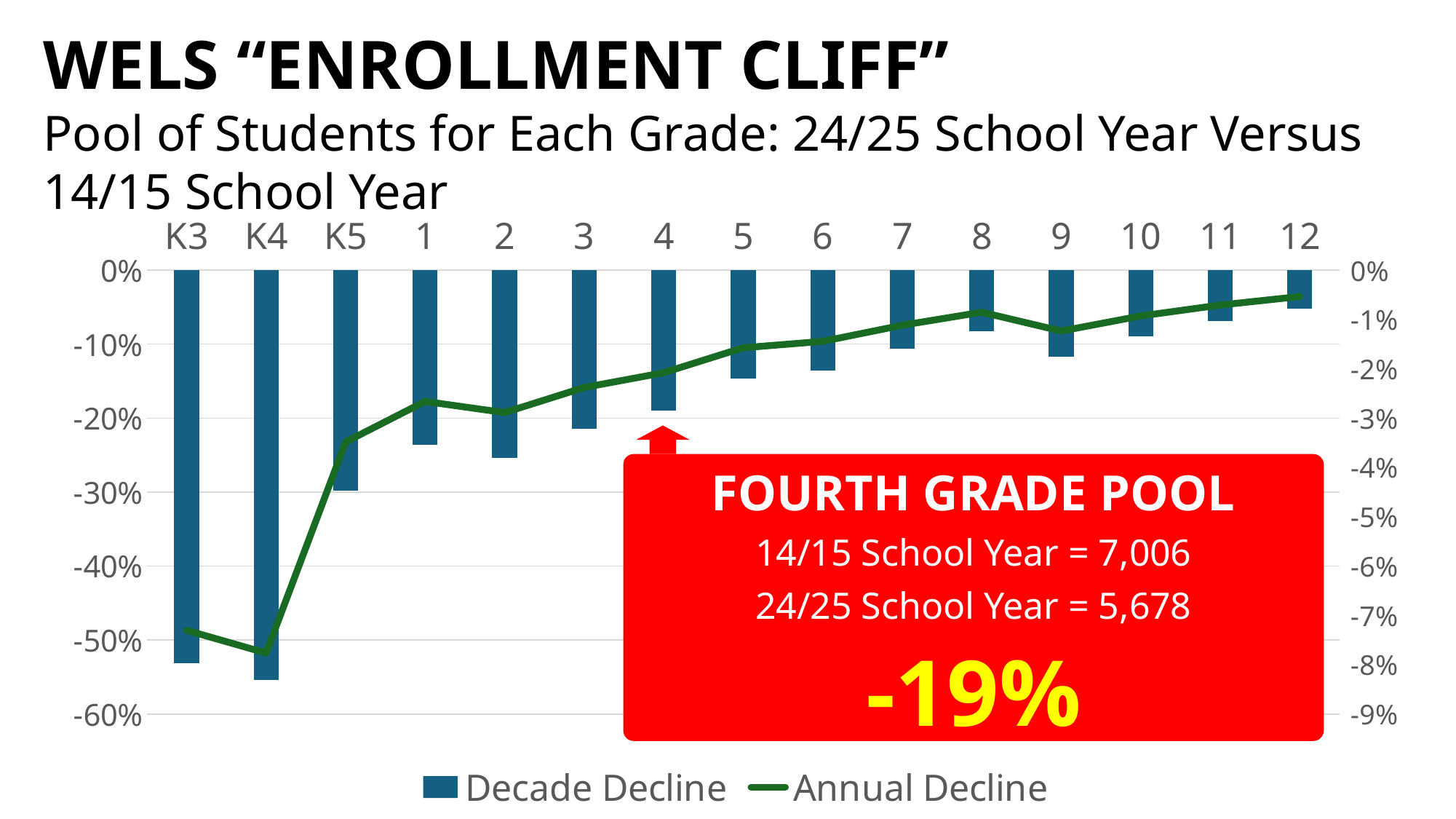
What was the fourth grade pool in the 24/25 school year? 5,678 How many series does the legend list? 2 How many grade categories are plotted along the x axis? 15 What are the two series named in the legend? Decade Decline and Annual Decline What kind of chart is shown on the slide? A combination bar and line chart Which has the larger Decade Decline, K3 or grade 12? K3 Which grade has the smallest Decade Decline (bar closest to 0%)? 12 Is the Decade Decline value for K5 greater or less than -20%? less What was the fourth grade pool in the 14/15 school year? 7,006 By how many students did the fourth grade pool fall from the 14/15 school year to the 24/25 school year? 1,328 What is the Decade Decline value for the fourth grade pool? -19% How do the Decade Decline bars change moving from K3 to grade 12? The decline shrinks, with bars getting closer to 0%